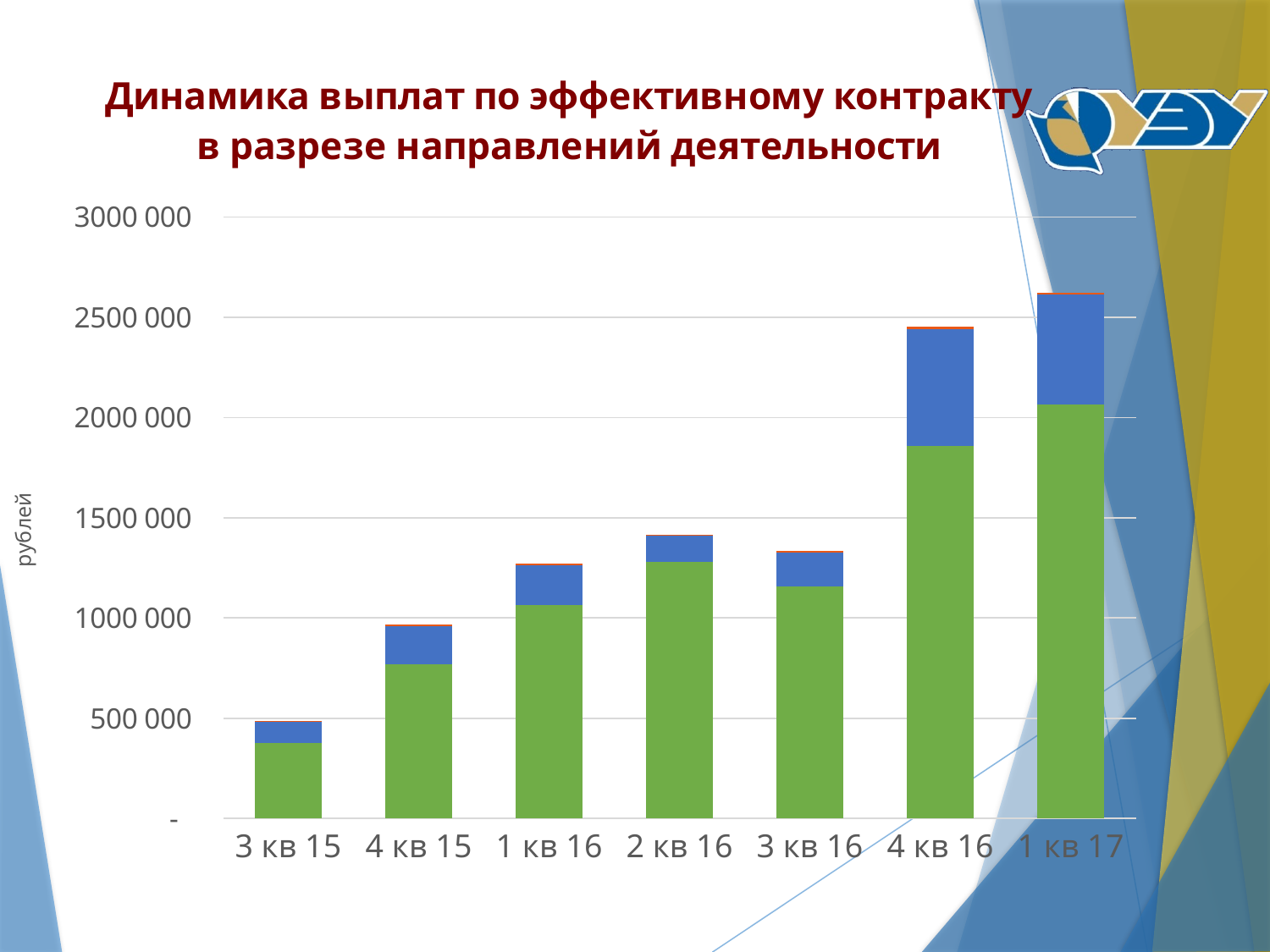
Do the total values generally rise or fall from 3 кв 15 to 1 кв 17? rise What kind of chart is shown on the slide? Stacked bar chart Is the total value for 4 кв 15 greater or less than 1000 000? less Which quarter has the lowest total bar? 3 кв 15 Is the total value for 1 кв 17 greater or less than 2500 000? greater Which has the larger total bar, 4 кв 16 or 3 кв 16? 4 кв 16 Is the total value for 4 кв 16 greater or less than 2500 000? less What unit is given on the vertical axis label? рублей How many quarters (categories) are shown on the x axis? 7 Which quarter has the highest total bar? 1 кв 17